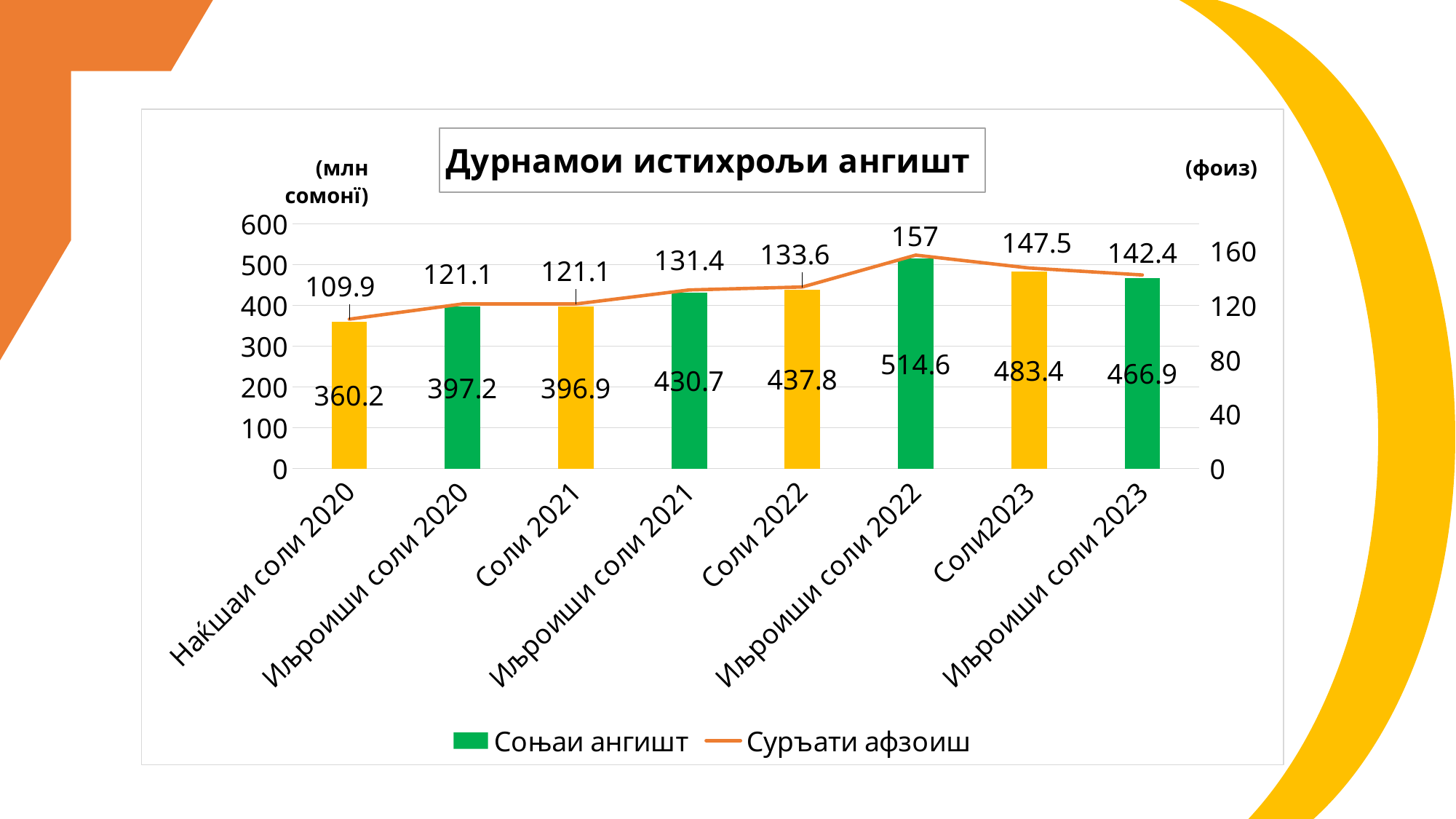
What is the Суръати афзоиш value for Наќшаи соли 2020? 109.9 How many categories are shown on the x axis? 8 Which is larger, the Соњаи ангишт value for Соли2023 or for Иљроиши соли 2023? Соли2023 What is the value of the Соњаи ангишт bar for Иљроиши соли 2022? 514.6 What is the title of the chart? Дурнамои истихрољи ангишт What kind of chart is this? Combined bar and line chart Which category has the highest Соњаи ангишт bar? Иљроиши соли 2022 Does the Суръати афзоиш line rise or fall from Наќшаи соли 2020 to Иљроиши соли 2022? Rise How many series does the legend list? 2 Which category has the lowest Суръати афзоиш value? Наќшаи соли 2020 What is the Соњаи ангишт value for Соли 2021? 396.9 What is the difference between the Соњаи ангишт values for Иљроиши соли 2022 and Иљроиши соли 2023? 47.7